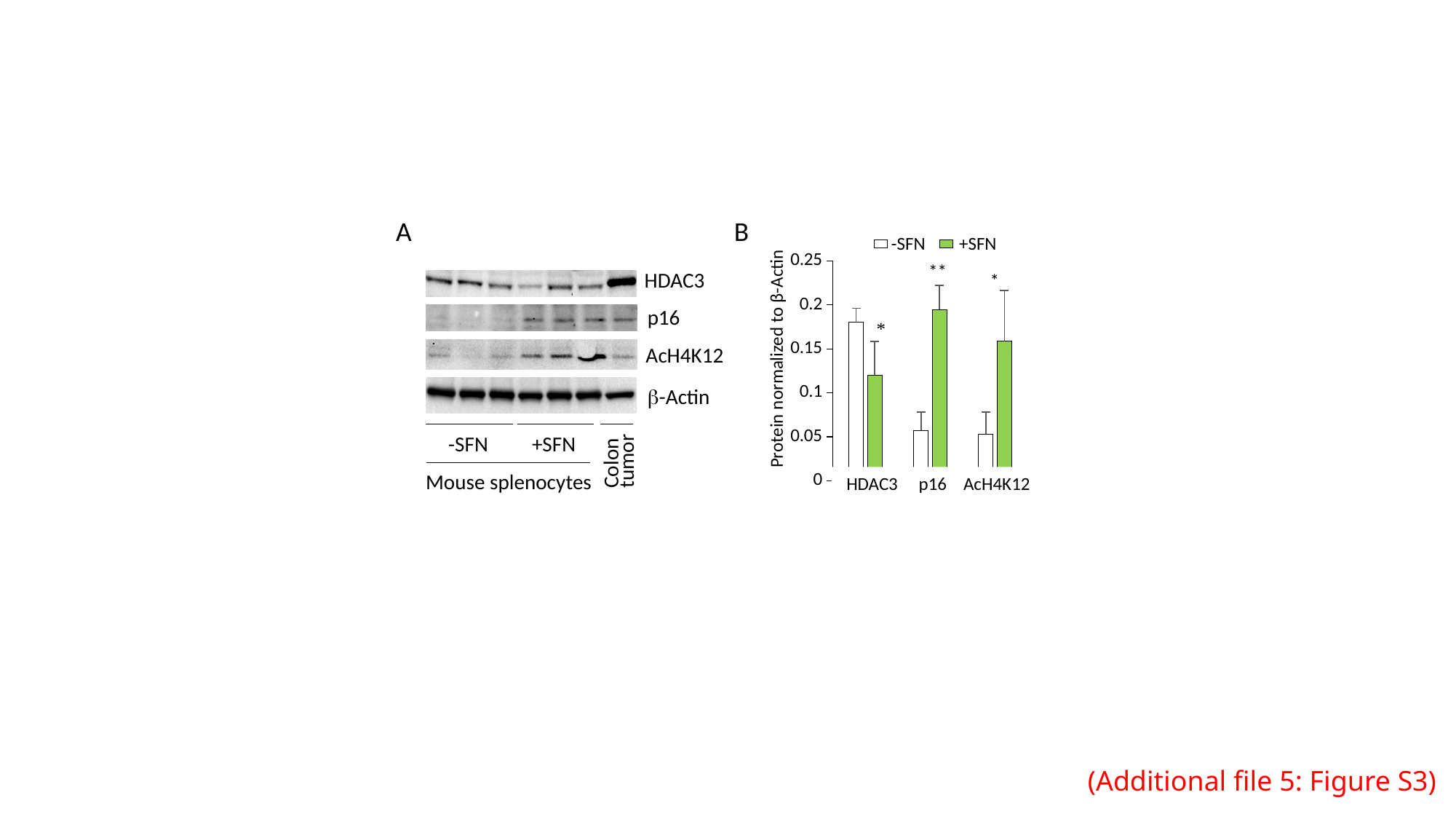
In chart B, what is the y-axis title? Protein normalized to β-Actin In chart B, is the +SFN value for p16 greater or less than 0.15? greater In chart B, is the +SFN value for HDAC3 greater or less than 0.15? less In chart B, which category has the highest +SFN value? p16 In chart B, for p16, which is larger: the -SFN value or the +SFN value? +SFN In chart B, how many series does the legend list? 2 In chart B, for HDAC3, which is larger: the -SFN value or the +SFN value? -SFN In chart B, is the -SFN value for p16 greater or less than 0.1? less In chart B, what kind of chart is shown? bar chart In chart B, how many categories are shown on the x axis? 3